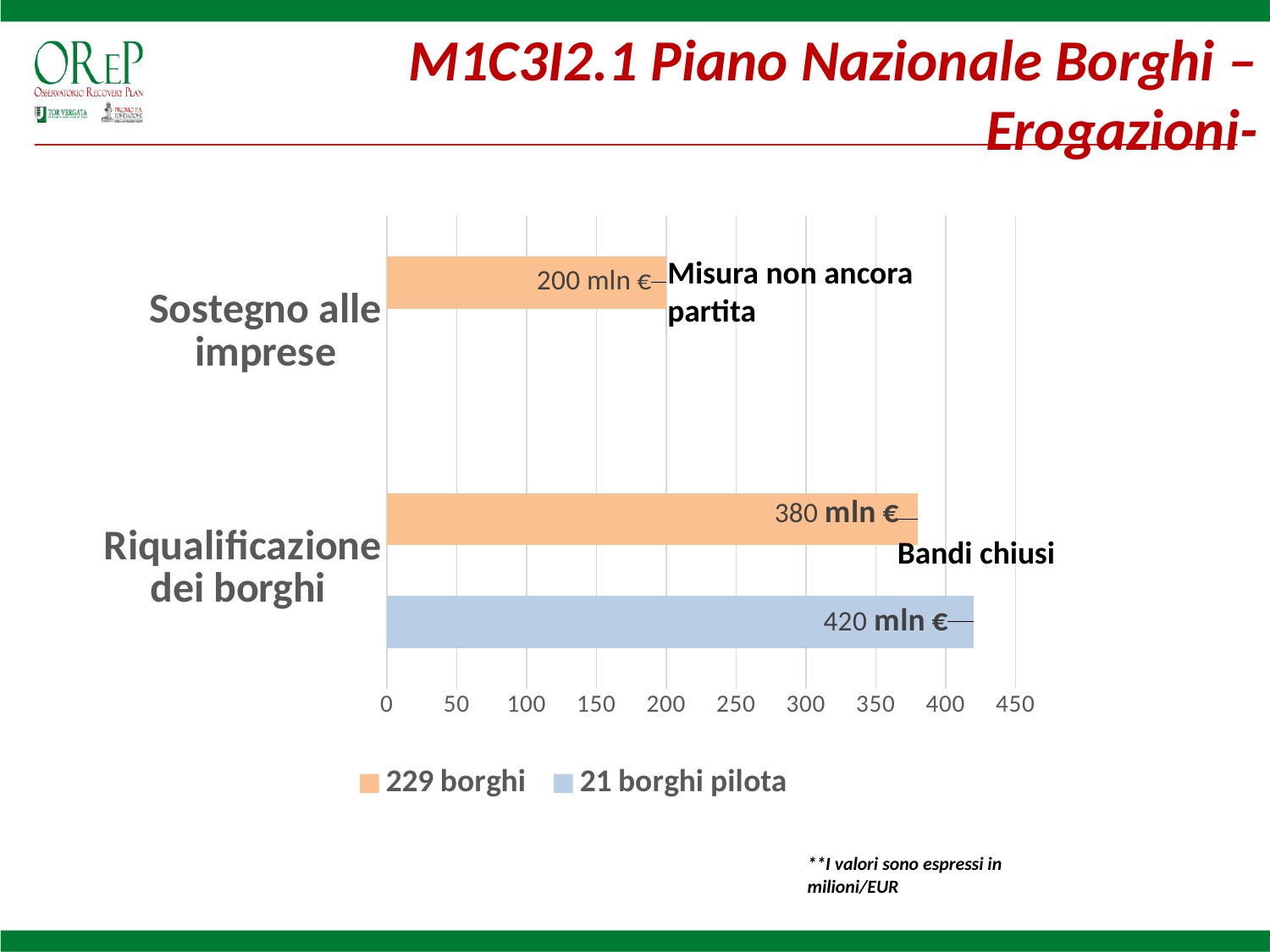
What annotation is shown next to the "Sostegno alle imprese" bar? Misura non ancora partita Which is larger for "Riqualificazione dei borghi": the "229 borghi" value or the "21 borghi pilota" value? 21 borghi pilota What is the value for "229 borghi" in the "Sostegno alle imprese" category? 200 mln € What is the difference between the "229 borghi" values for "Riqualificazione dei borghi" and "Sostegno alle imprese"? 180 mln € What kind of chart is shown on the slide? bar chart Which bar has the lowest value in the chart? 229 borghi, Sostegno alle imprese How many categories are shown on the vertical axis? 2 How many series does the legend list? 2 What is the difference between the "21 borghi pilota" and "229 borghi" values for "Riqualificazione dei borghi"? 40 mln € Which bar has the highest value in the chart? 21 borghi pilota, Riqualificazione dei borghi What is the value for "229 borghi" in the "Riqualificazione dei borghi" category? 380 mln € What is the value for "21 borghi pilota" in the "Riqualificazione dei borghi" category? 420 mln €